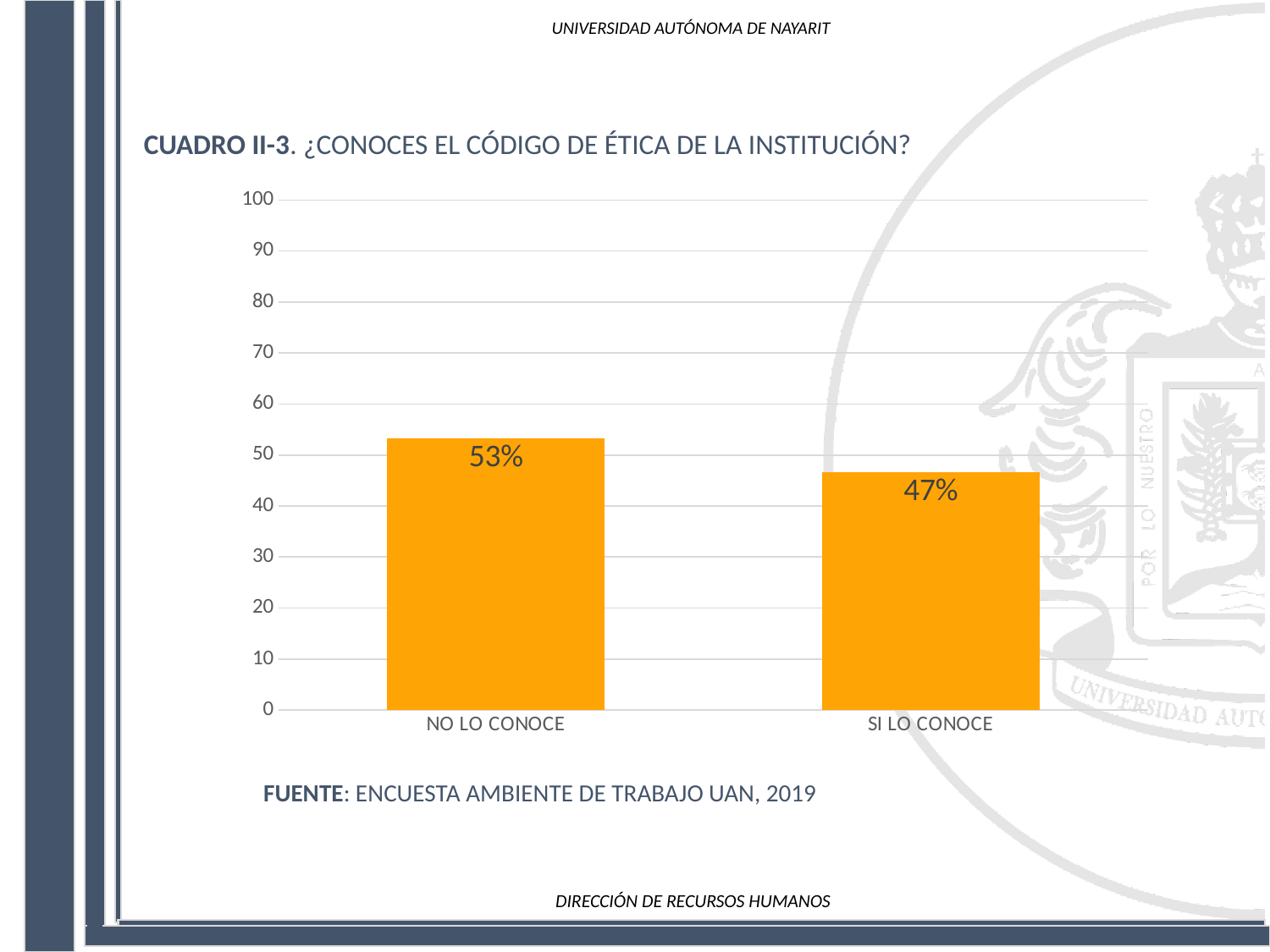
What kind of chart is shown on the slide? bar chart Is the value for SI LO CONOCE greater or less than 50? less Is the value for NO LO CONOCE greater or less than 50? greater Which is larger, the value for NO LO CONOCE or the value for SI LO CONOCE? NO LO CONOCE What is the difference between the values for NO LO CONOCE and SI LO CONOCE? 6% What is the maximum value shown on the vertical axis? 100 How many categories are shown on the x axis? 2 What is the value for NO LO CONOCE? 53% What is the value for SI LO CONOCE? 47% Which category has the highest value? NO LO CONOCE Which category has the lowest value? SI LO CONOCE What source is cited below the chart? ENCUESTA AMBIENTE DE TRABAJO UAN, 2019